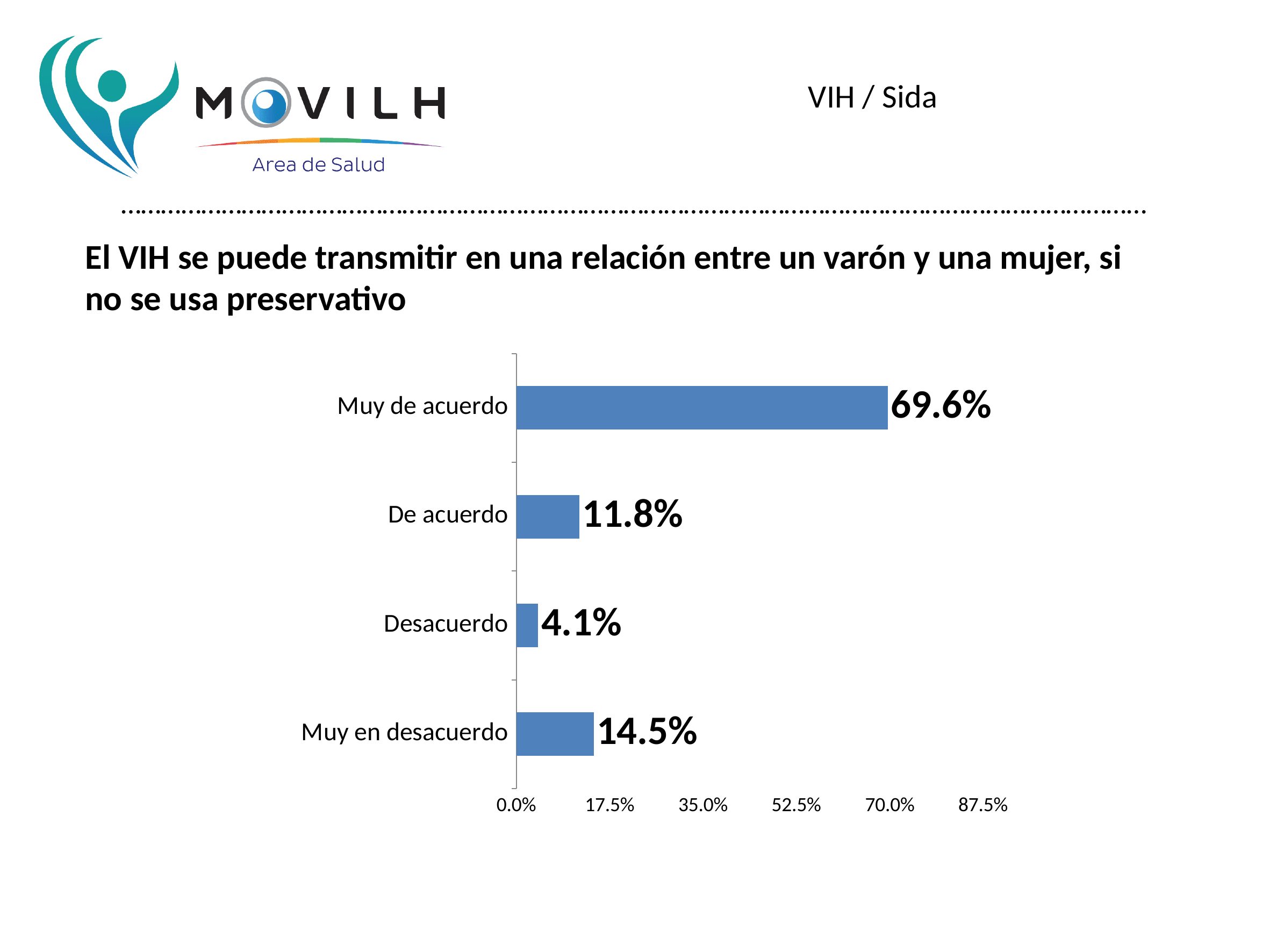
Which is larger, the value for "De acuerdo" or the value for "Muy en desacuerdo"? Muy en desacuerdo What is the value for "Muy en desacuerdo"? 14.5% What is the difference between the values for "Muy en desacuerdo" and "Desacuerdo"? 10.4% How many categories are shown in the chart? 4 Which category has the lowest value? Desacuerdo What kind of chart is shown on the slide? bar chart Which category has the highest value? Muy de acuerdo What is the value for "Muy de acuerdo"? 69.6% What is the value for "Desacuerdo"? 4.1% What is the difference between the values for "Muy de acuerdo" and "De acuerdo"? 57.8% What is the value for "De acuerdo"? 11.8% Is the value for "Muy de acuerdo" greater or less than 52.5%? greater